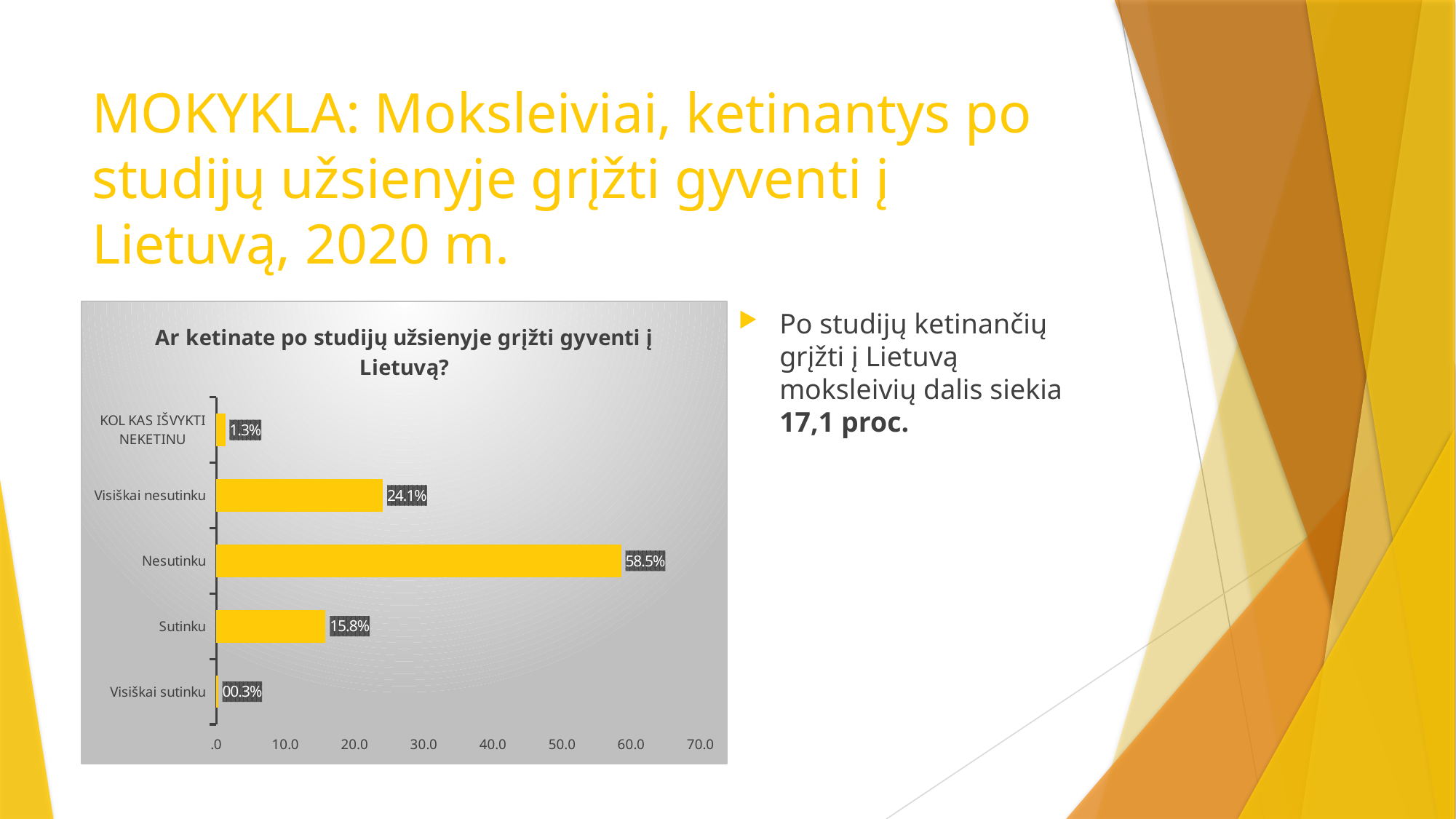
Which category has the highest value? Nesutinku What kind of chart is shown on the slide? Bar chart Which is larger, the value for Visiškai nesutinku or the value for Sutinku? Visiškai nesutinku How many categories are shown in the chart? 5 What is the title of the chart? Ar ketinate po studijų užsienyje grįžti gyventi į Lietuvą? What is the value for Sutinku? 15.8% What is the value for KOL KAS IŠVYKTI NEKETINU? 1.3% Is the value for Nesutinku greater or less than 50.0? greater What is the difference between the values for Nesutinku and Visiškai nesutinku? 34.4 percentage points What is the value for Nesutinku? 58.5% What is the value for Visiškai nesutinku? 24.1% Which category has the lowest value? Visiškai sutinku